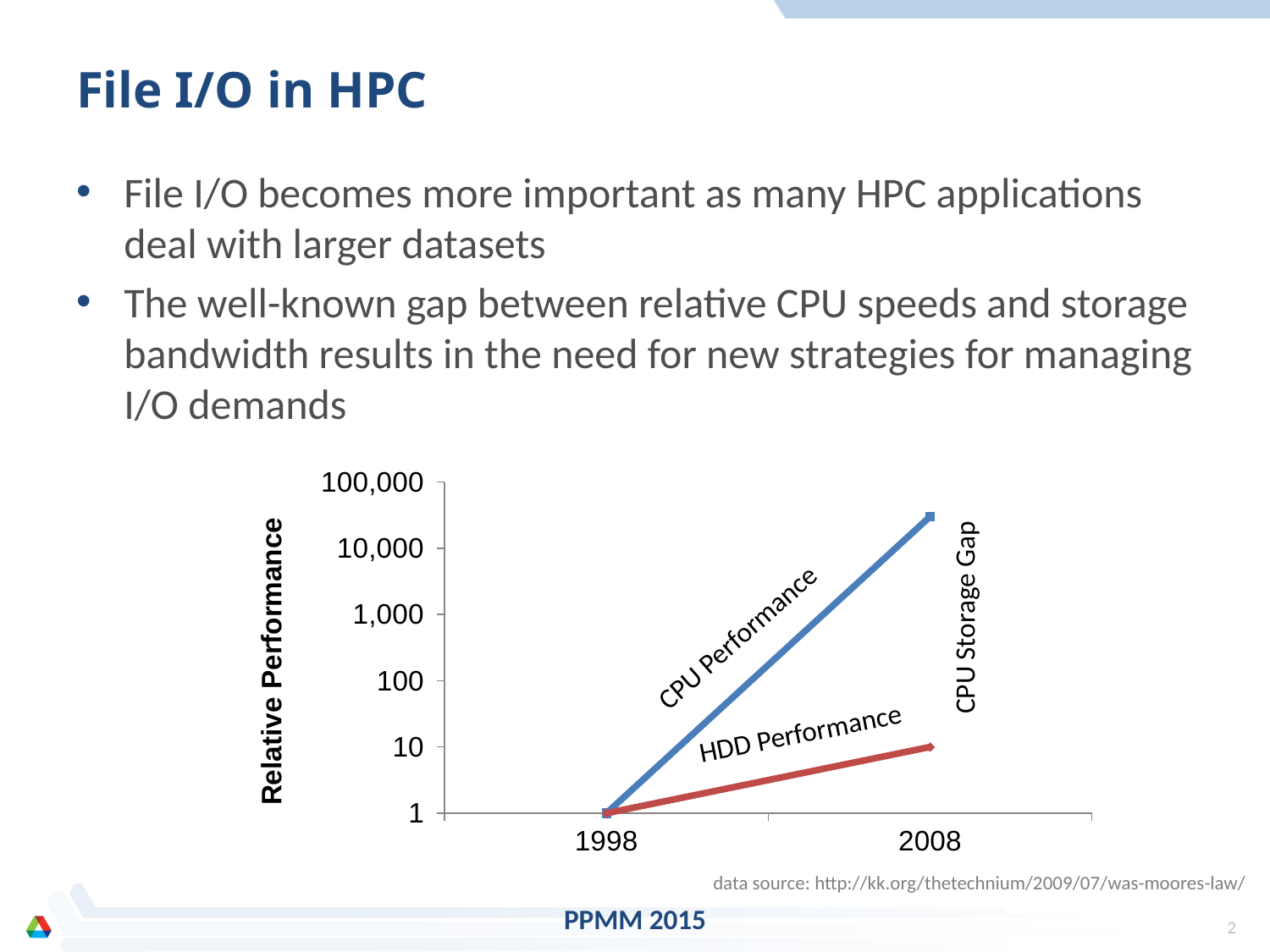
Which series has the higher value in 2008, CPU Performance or HDD Performance? CPU Performance Does CPU Performance rise or fall from 1998 to 2008? rise What is the value for HDD Performance in 1998? 1 Is the value for HDD Performance in 2008 greater or less than 100? less What kind of chart is shown on the slide? line chart How many series are plotted in the chart? 2 What are the names of the two series plotted in the chart? CPU Performance and HDD Performance What is the label of the y axis of the chart? Relative Performance Does HDD Performance rise or fall from 1998 to 2008? rise What is the value for CPU Performance in 1998? 1 Which years are marked on the x axis of the chart? 1998 and 2008 Is the value for CPU Performance in 2008 greater or less than 10,000? greater